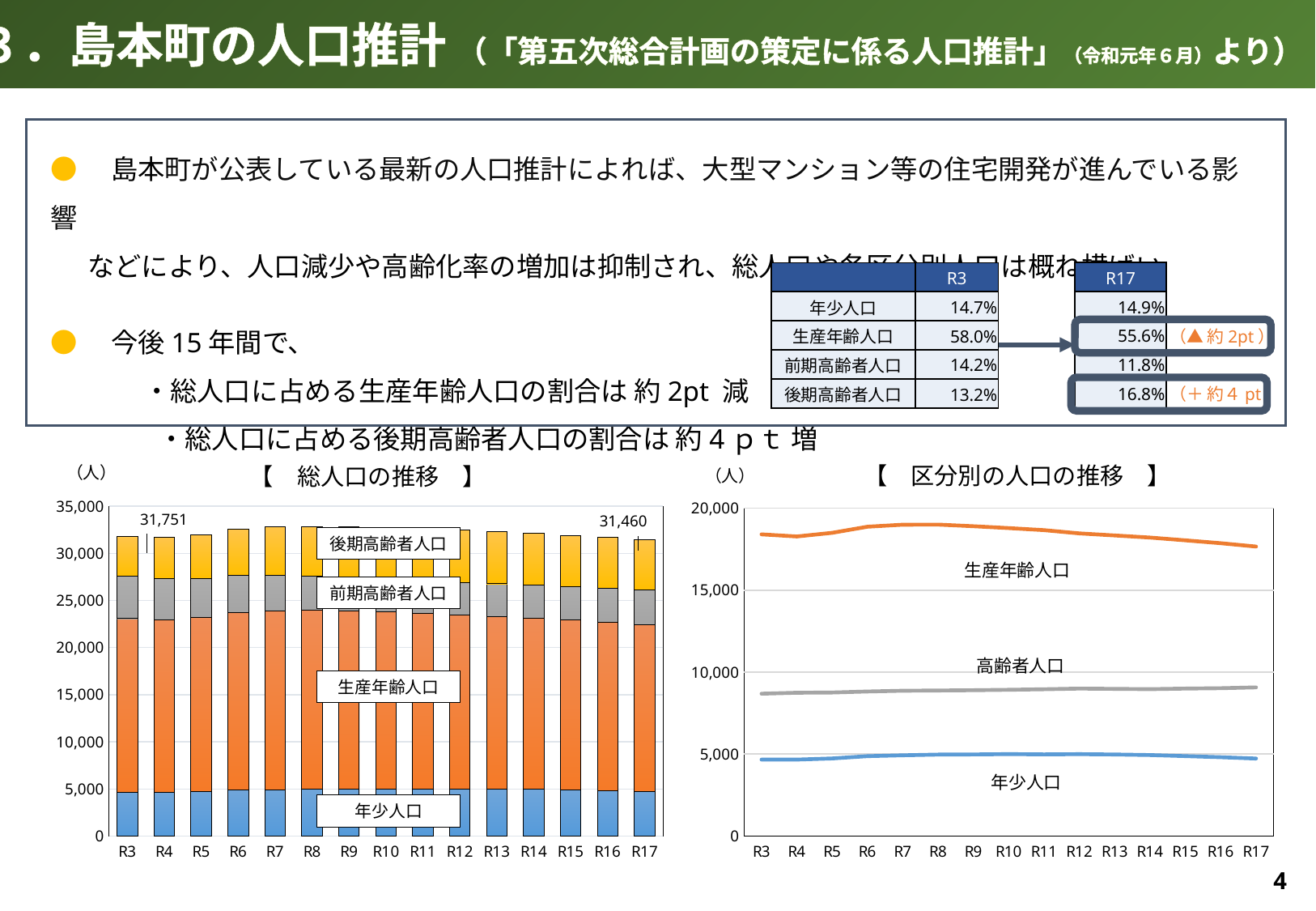
In the left chart (総人口の推移), how many population categories are stacked in each bar? 4 What kind of chart is the left chart titled 総人口の推移? bar chart In the left chart (総人口の推移), how many years are shown on the x axis? 15 What kind of chart is the right chart titled 区分別の人口の推移? line chart In the left chart (総人口の推移), what is the difference between the labelled totals for R3 and R17? 291 In the right chart (区分別の人口の推移), how many lines (population categories) are plotted? 3 In the right chart (区分別の人口の推移), which category has the highest values across all years? 生産年齢人口 In the left chart (総人口の推移), which labelled total is larger, R3 or R17? R3 In the left chart (総人口の推移), what is the total population value labelled for R3? 31,751 In the right chart (区分別の人口の推移), which category has the lowest values across all years? 年少人口 In the right chart (区分別の人口の推移), is the value for 生産年齢人口 at R3 greater or less than 15,000? greater In the left chart (総人口の推移), what is the total population value labelled for R17? 31,460